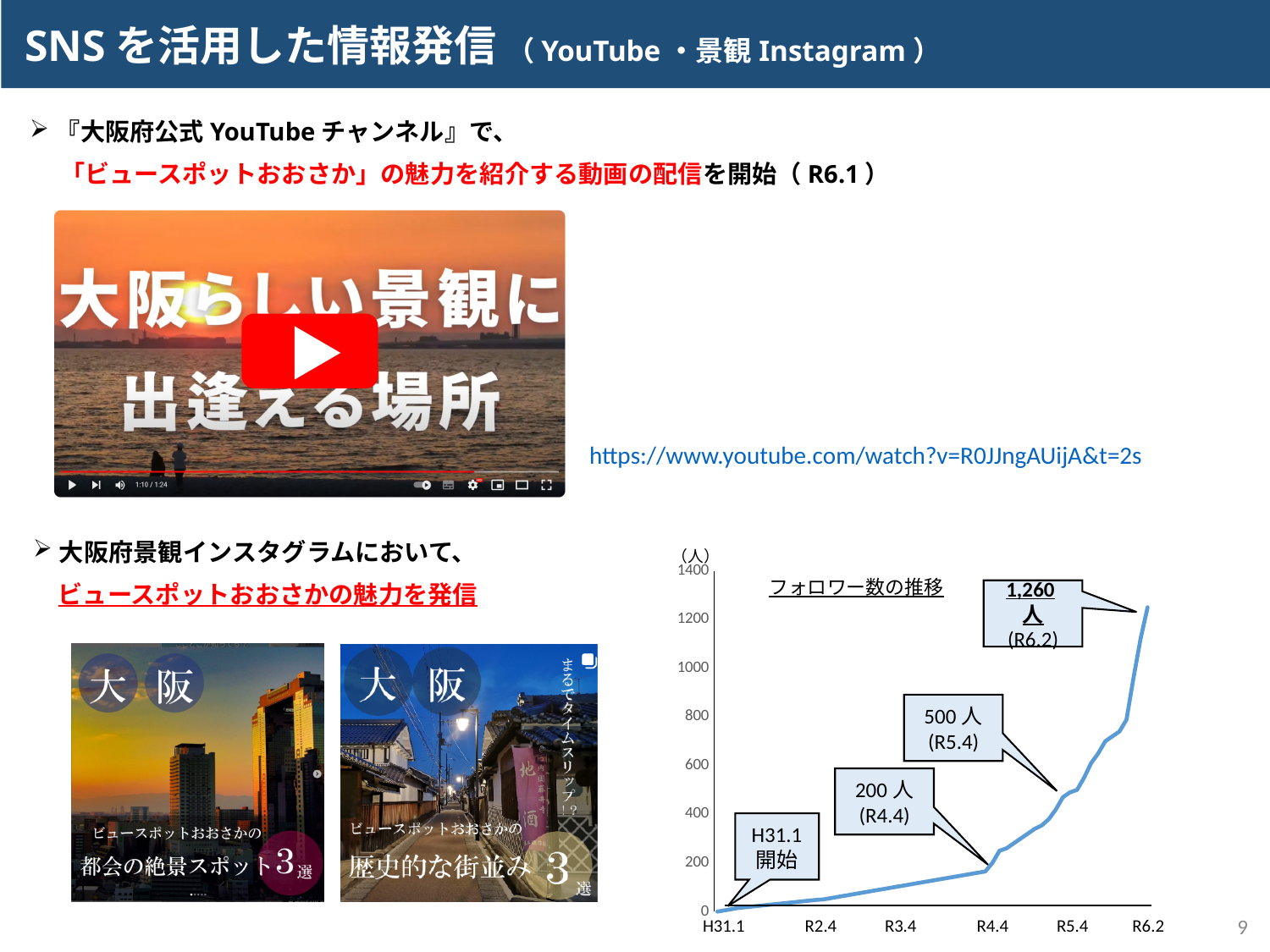
What is the title of the chart on the slide? フォロワー数の推移 How many labels are shown on the x axis of the chart? 6 What kind of chart is shown on the slide? line chart What is the follower count labelled at R5.4 in the chart? 500人 By how much did the follower count increase from R5.4 to R6.2? 760人 What is the follower count labelled at R4.4 in the chart? 200人 Which is larger, the follower count at R5.4 or at R4.4? R5.4 What is the follower count labelled at R6.2 in the chart? 1,260人 Is the follower count at R3.4 greater or less than 200? less By how much did the follower count increase from R4.4 to R5.4? 300人 Do the follower counts rise or fall along the x axis? rise At which x-axis point is the follower count highest? R6.2